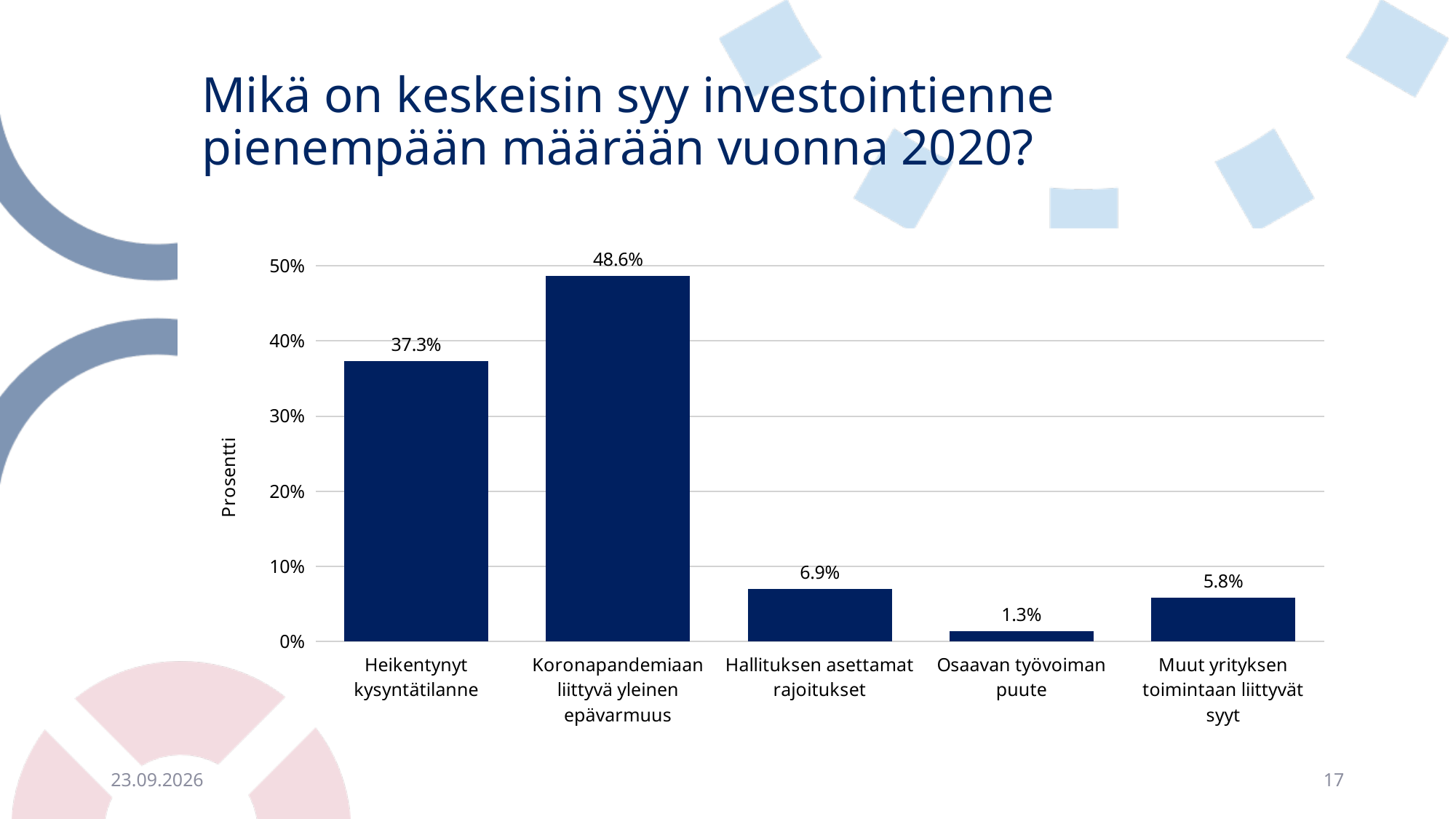
Which category has the highest value? Koronapandemiaan liittyvä yleinen epävarmuus How many categories are shown in the chart? 5 What is the value for Koronapandemiaan liittyvä yleinen epävarmuus? 48.6% What kind of chart is shown on the slide? Bar chart What is the value for Muut yrityksen toimintaan liittyvät syyt? 5.8% What is the label of the vertical axis? Prosentti What is the value for Osaavan työvoiman puute? 1.3% What is the difference between the values for Koronapandemiaan liittyvä yleinen epävarmuus and Heikentynyt kysyntätilanne? 11.3% What is the value for Hallituksen asettamat rajoitukset? 6.9% Which category has the lowest value? Osaavan työvoiman puute Which is larger, the value for Hallituksen asettamat rajoitukset or the value for Muut yrityksen toimintaan liittyvät syyt? Hallituksen asettamat rajoitukset What is the value for Heikentynyt kysyntätilanne? 37.3%